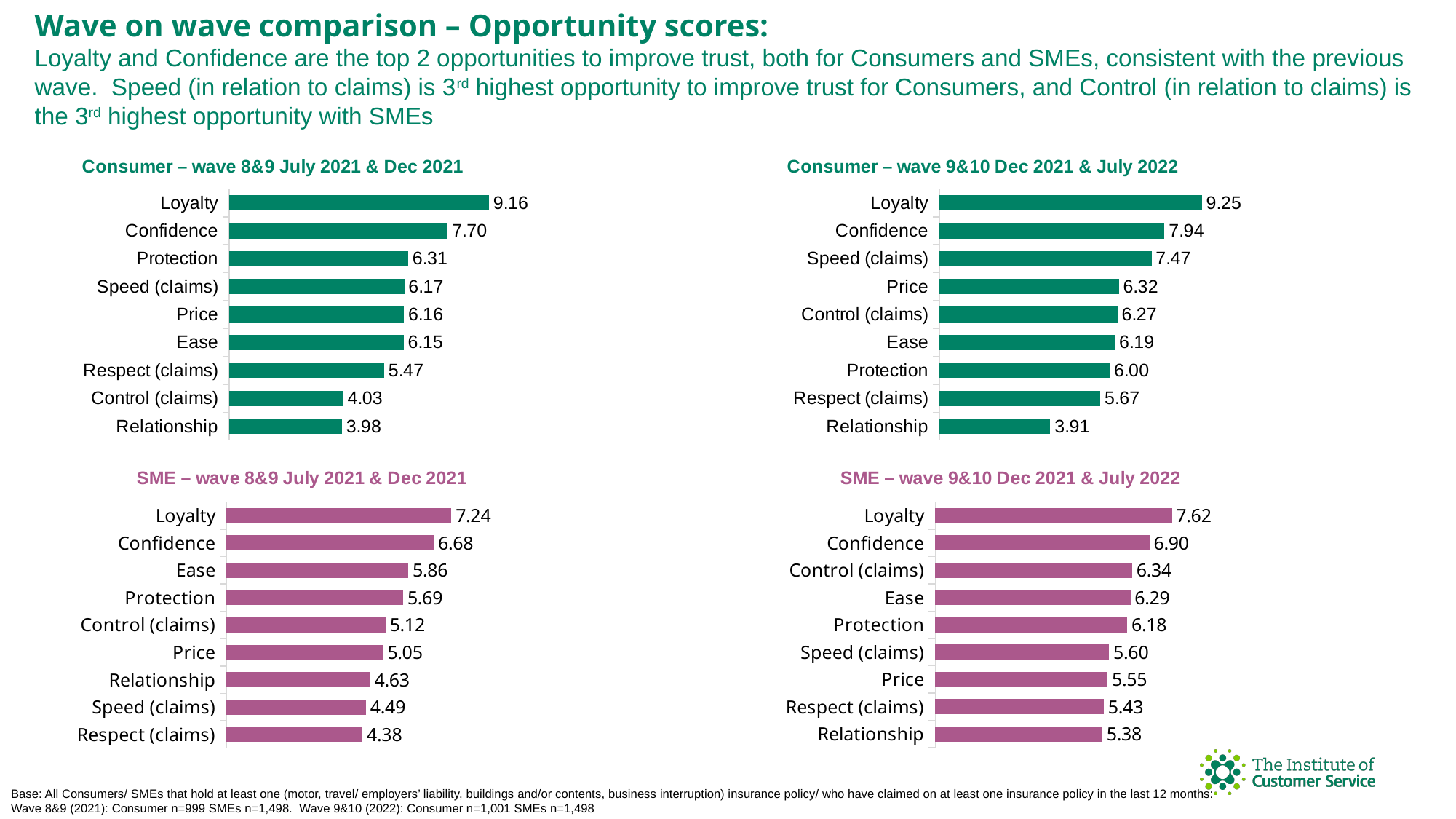
In the 'Consumer – wave 9&10 Dec 2021 & July 2022' chart, what is the value for Speed (claims)? 7.47 In the 'SME – wave 9&10 Dec 2021 & July 2022' chart, what is the difference between Loyalty and Relationship? 2.24 In the 'Consumer – wave 8&9 July 2021 & Dec 2021' chart, what is the value for Protection? 6.31 In the 'Consumer – wave 8&9 July 2021 & Dec 2021' chart, which is larger: Respect (claims) or Control (claims)? Respect (claims) What type of chart is the 'Consumer – wave 8&9 July 2021 & Dec 2021' chart? Bar chart In the 'Consumer – wave 9&10 Dec 2021 & July 2022' chart, which category has the highest value? Loyalty How many charts are shown on the slide? 4 In the 'SME – wave 8&9 July 2021 & Dec 2021' chart, what is the value for Relationship? 4.63 In the 'SME – wave 8&9 July 2021 & Dec 2021' chart, which category has the lowest value? Respect (claims) In the 'SME – wave 9&10 Dec 2021 & July 2022' chart, what is the value for Control (claims)? 6.34 How many categories are shown in the 'SME – wave 9&10 Dec 2021 & July 2022' chart? 9 In the 'Consumer – wave 8&9 July 2021 & Dec 2021' chart, what is the difference between Loyalty and Confidence? 1.46